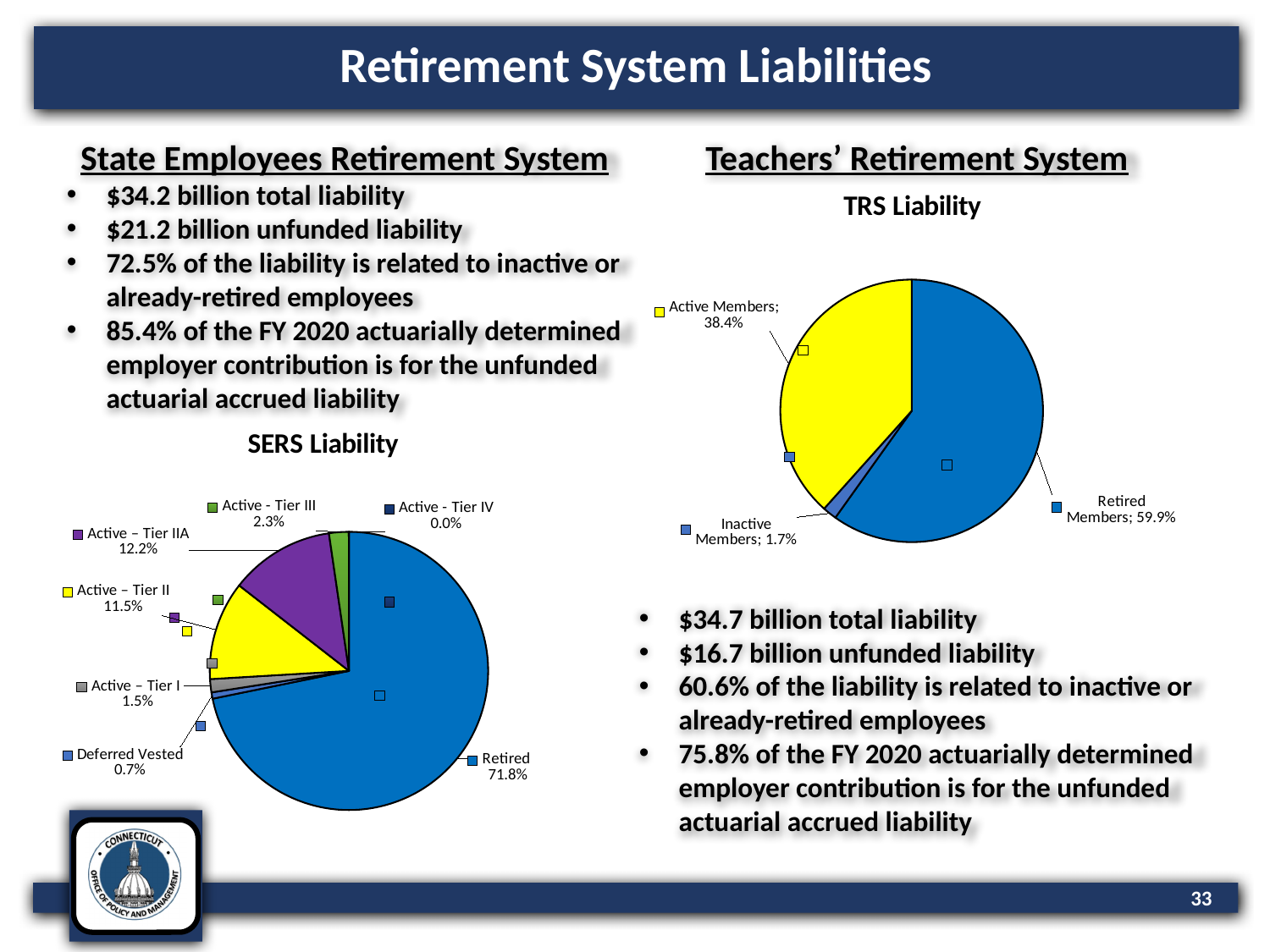
In the SERS Liability chart, what is the value for Active – Tier IIA? 12.2% In the SERS Liability chart, what is the value for Deferred Vested? 0.7% In the SERS Liability chart, what share of the liability is for Retired members? 71.8% In the SERS Liability chart, how many categories are shown? 7 In the SERS Liability chart, what is the difference between Active – Tier IIA and Active – Tier II? 0.7% In the TRS Liability chart, what share of the liability is for Active Members? 38.4% In the TRS Liability chart, which is larger, Retired Members or Active Members? Retired Members What type of chart is the TRS Liability chart? Pie chart In the TRS Liability chart, what is the value for Inactive Members? 1.7% In the SERS Liability chart, which category has the smallest share? Active - Tier IV In the SERS Liability chart, which category has the largest share? Retired In the SERS Liability chart, what is the value for Active – Tier II? 11.5%